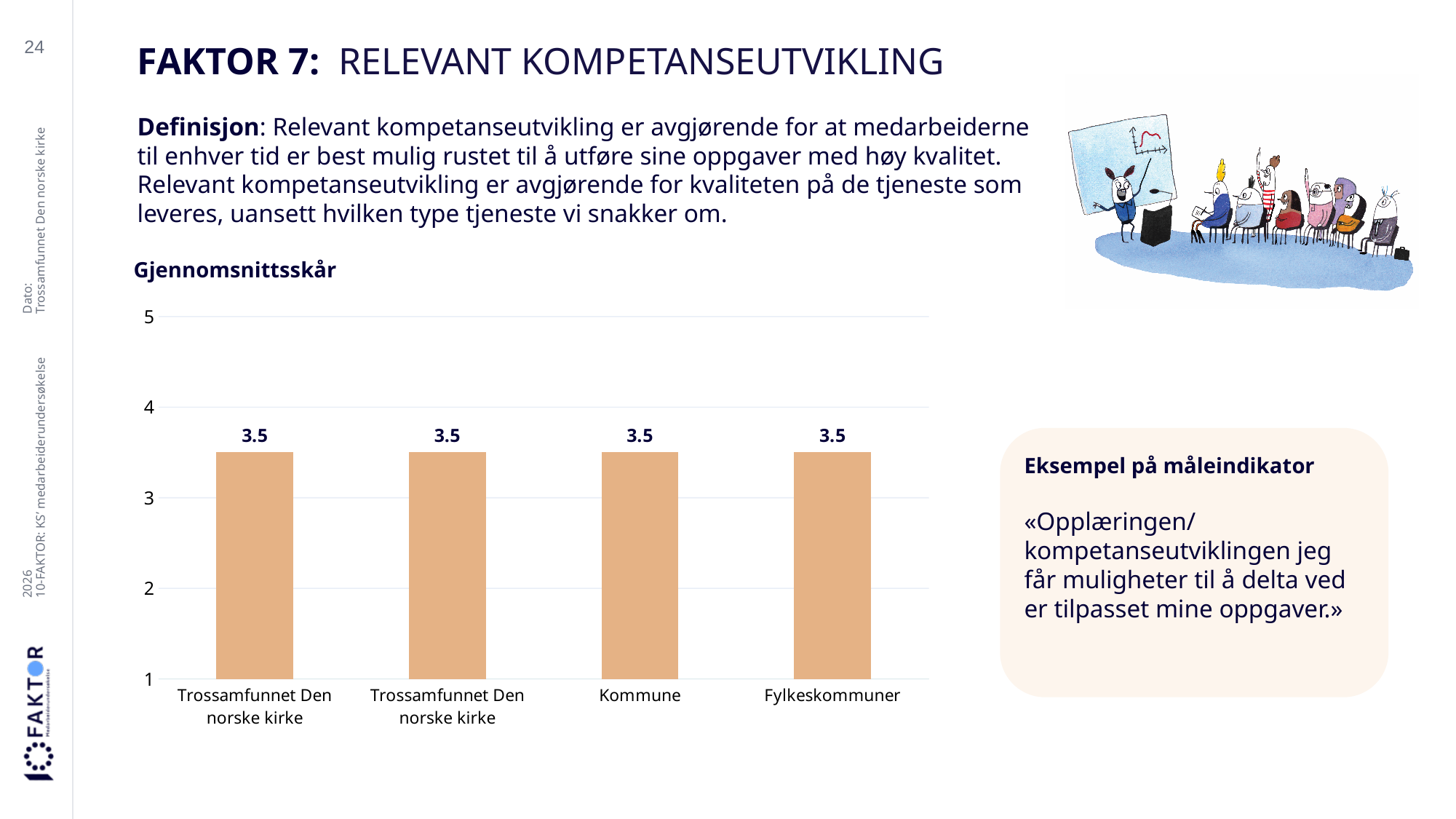
What kind of chart is the Gjennomsnittsskår chart? bar chart Do the values in the Gjennomsnittsskår chart rise, fall, or stay the same across the categories? stay the same What is the title of the chart on the slide? Gjennomsnittsskår Is the value for Kommune in the Gjennomsnittsskår chart greater or less than 4? less What is the highest value shown on the vertical axis of the Gjennomsnittsskår chart? 5 What is the value shown for the first bar, Trossamfunnet Den norske kirke, in the Gjennomsnittsskår chart? 3.5 What is the difference between the values for Kommune and Fylkeskommuner in the Gjennomsnittsskår chart? 0 Is the value for Fylkeskommuner in the Gjennomsnittsskår chart greater or less than 3? greater What is the value for Fylkeskommuner in the Gjennomsnittsskår chart? 3.5 What is the value for Kommune in the Gjennomsnittsskår chart? 3.5 How many bars are shown in the Gjennomsnittsskår chart? 4 Do all four bars in the Gjennomsnittsskår chart have the same value? Yes